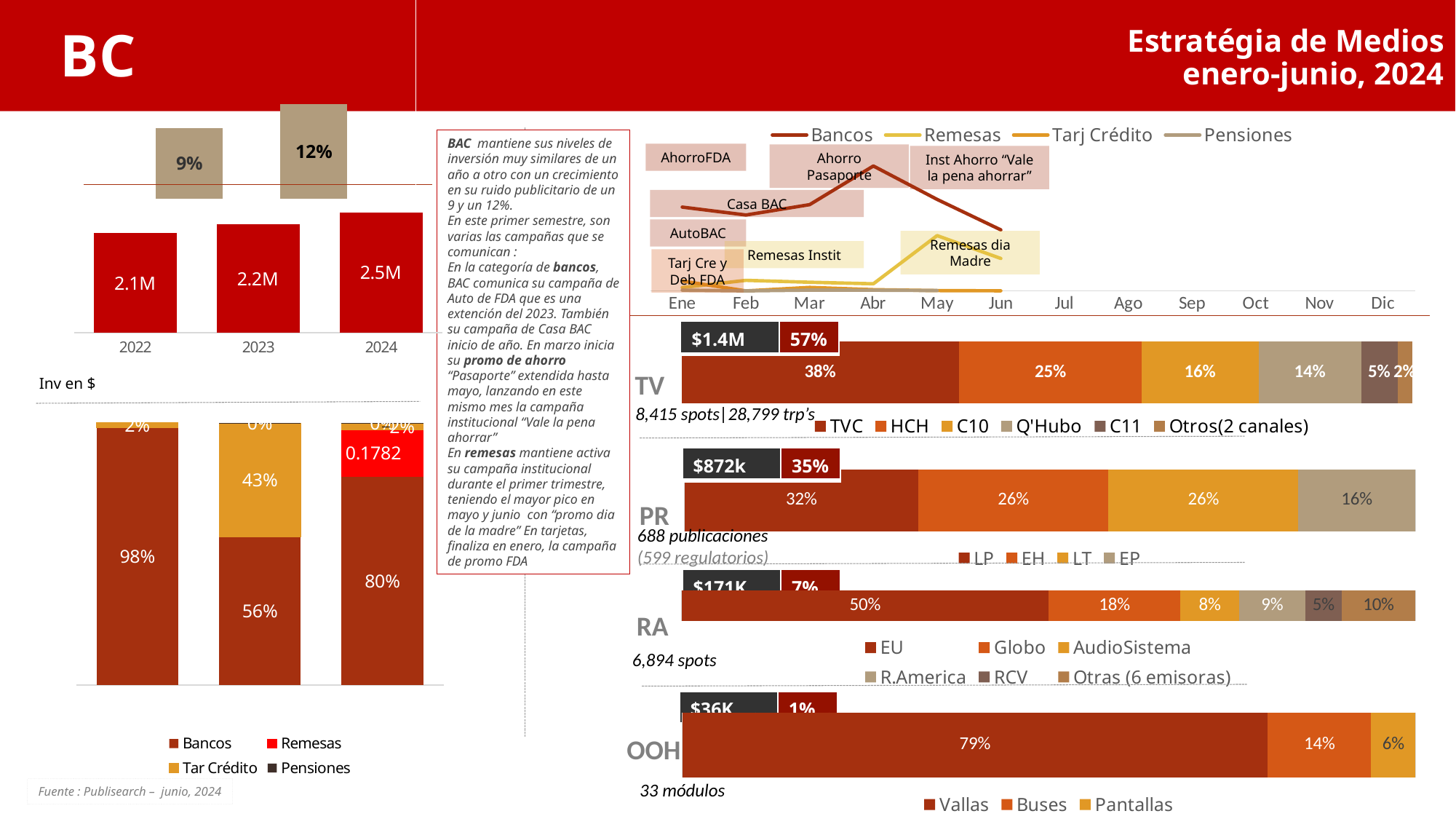
In the 'Inv en $' bar chart on the left, which year has the lowest investment? 2022 In the RA stacked bar, which is larger, the share for Globo or the share for AudioSistema? Globo In the 'Inv en $' bar chart on the left, what is the value for 2024? 2.5M In the stacked bar chart at the bottom left, what is the Bancos share for 2023? 56% In the OOH stacked bar, how many categories does the legend list? 3 In the 'Inv en $' bar chart on the left, what is the growth percentage shown between 2023 and 2024? 12% In the TV stacked bar, which channel has the largest share? TVC In the TV stacked bar, what is the share for HCH? 25% In the stacked bar chart at the bottom left, how many series does the legend list? 4 In the 'Inv en $' bar chart on the left, how many years are shown? 3 What kind of chart is the top-right chart showing Bancos, Remesas, Tarj Crédito and Pensiones by month? Line chart In the PR stacked bar, what is the difference between the LP share and the EP share? 16%